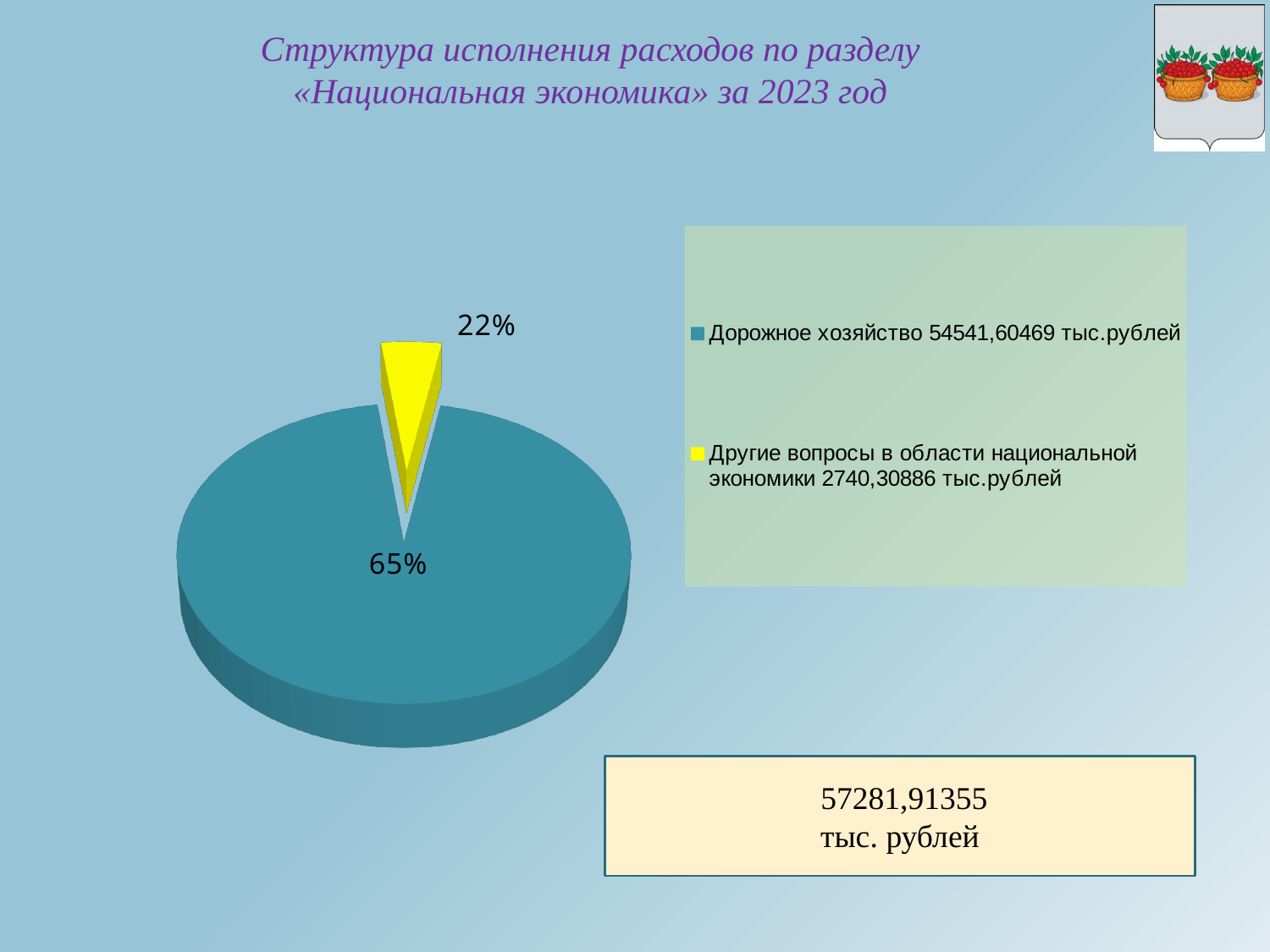
What is the total amount shown in the box below the chart? 57281,91355 тыс. рублей What kind of chart is shown on the slide? pie chart Which category has the largest slice of the pie? Дорожное хозяйство According to the legend, what is the amount for Другие вопросы в области национальной экономики? 2740,30886 тыс.рублей What percentage label is shown on the slice for Дорожное хозяйство? 65% According to the legend, what is the amount for Дорожное хозяйство? 54541,60469 тыс.рублей What percentage label is shown on the slice for Другие вопросы в области национальной экономики? 22% How many slices does the pie chart have? 2 What colour is the slice for Другие вопросы в области национальной экономики? yellow Which category has the smallest slice of the pie? Другие вопросы в области национальной экономики What is the difference between the percentage labels of the two slices? 43% How many entries does the legend of the pie chart list? 2